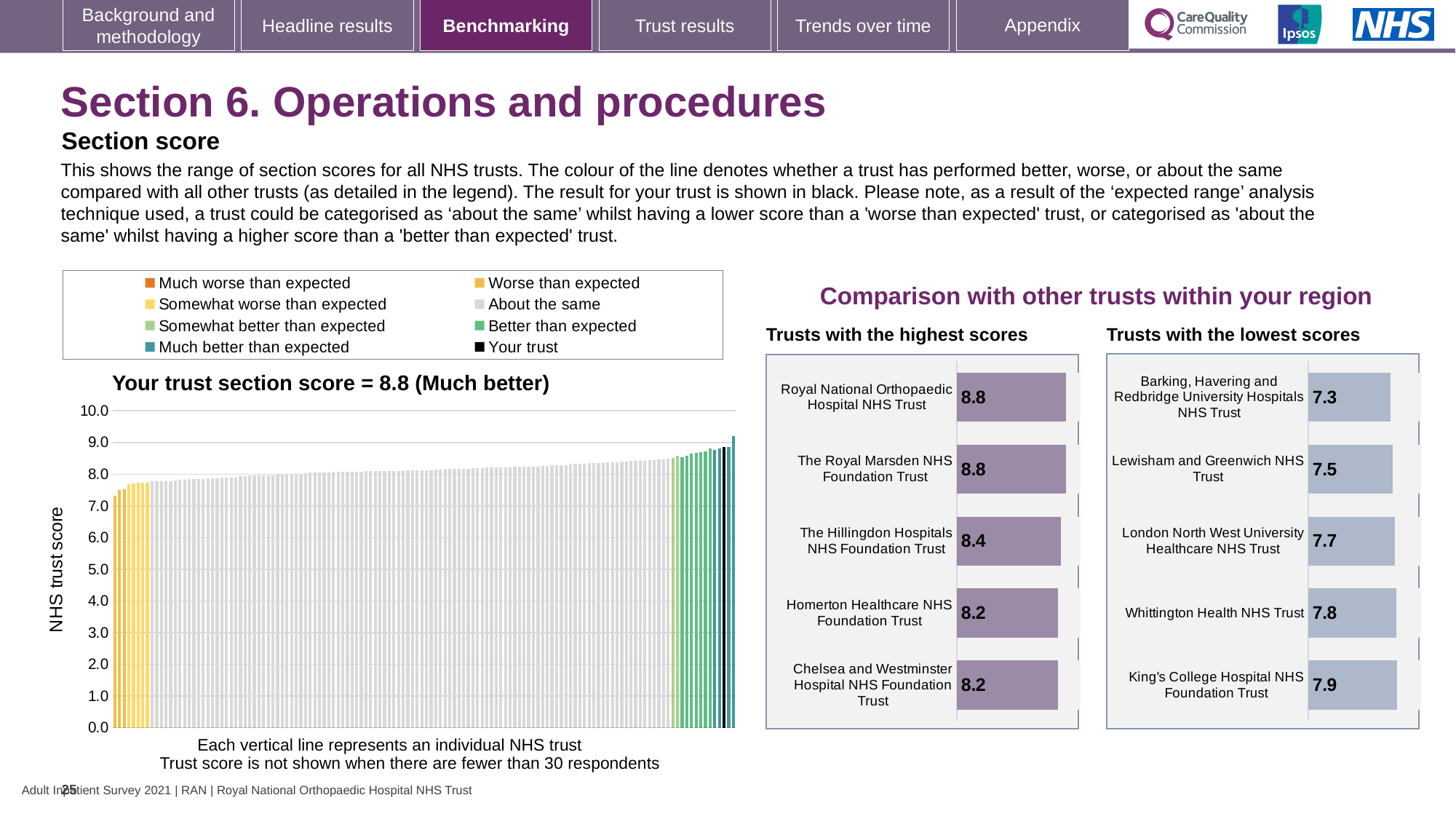
In the 'Your trust section score' chart, what kind of chart is shown? Bar chart In the 'Trusts with the lowest scores' chart, which trust has the lowest score? Barking, Havering and Redbridge University Hospitals NHS Trust In the 'Trusts with the lowest scores' chart, which has the higher score: Lewisham and Greenwich NHS Trust or King's College Hospital NHS Foundation Trust? King's College Hospital NHS Foundation Trust In the 'Your trust section score' chart, what is the section score for your trust as stated in the chart title? 8.8 In the 'Your trust section score' chart, what is the label on the vertical axis? NHS trust score How many entries does the legend above the 'Your trust section score' chart list? 8 In the 'Trusts with the lowest scores' chart, what is the score for Whittington Health NHS Trust? 7.8 In the 'Trusts with the highest scores' chart, how many trusts are shown? 5 In the 'Your trust section score' chart, is the value of the leftmost (lowest) bar greater or less than 8.0? less In the 'Trusts with the highest scores' chart, what is the score for The Hillingdon Hospitals NHS Foundation Trust? 8.4 In the 'Your trust section score' chart, do the bars rise or fall from left to right? Rise In the 'Trusts with the highest scores' chart, what is the difference between the score for Royal National Orthopaedic Hospital NHS Trust and the score for Homerton Healthcare NHS Foundation Trust? 0.6